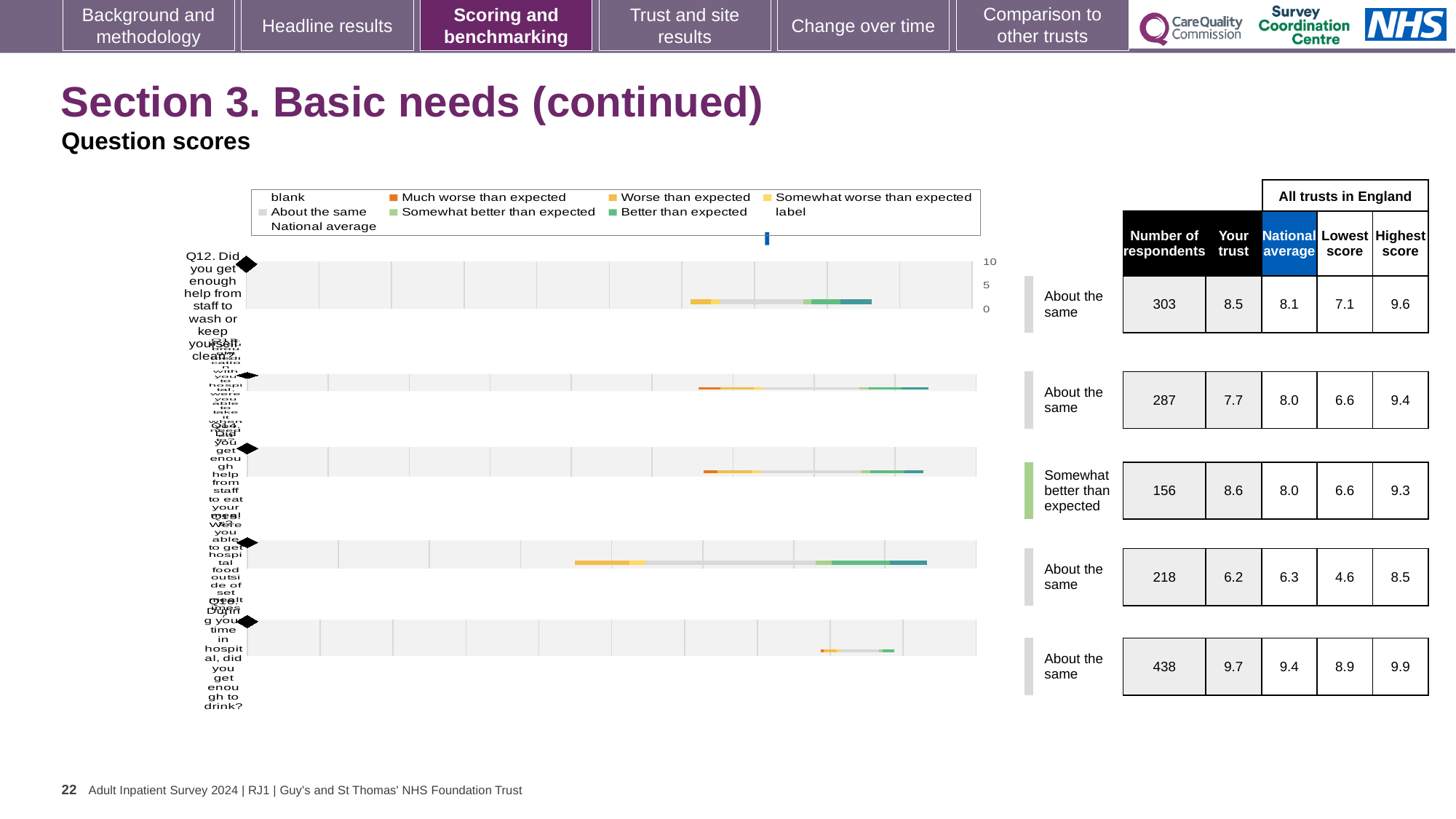
In the table beside the chart, which question row has the highest 'Your trust' score? Q16 (did you get enough to drink), 9.7 In the chart legend, what colour represents 'Much worse than expected'? orange Which legend entry in the chart is shown in dark blue? National average In the table beside the chart, what is the 'Your trust' score for Q12 (help from staff to wash or keep yourself clean)? 8.5 What kind of chart is shown on the slide? bar chart In the table beside the chart, how many respondents are listed for Q16 (did you get enough to drink)? 438 In the table beside the chart, for Q14 (help from staff to eat your meals), is the 'Your trust' score or the national average higher? Your trust (8.6) In the table beside the chart, what is the difference between the 'Your trust' score and the national average for Q12? 0.4 In the table beside the chart, what is the highest score across all trusts in England for Q16? 9.9 In the table beside the chart, which question row has the lowest 'Your trust' score? Q15 (hospital food outside of set meal times), 6.2 How many question rows (bars) does the chart show? 5 Which question row is labelled 'Somewhat better than expected' next to the chart? Q14 (help from staff to eat your meals)